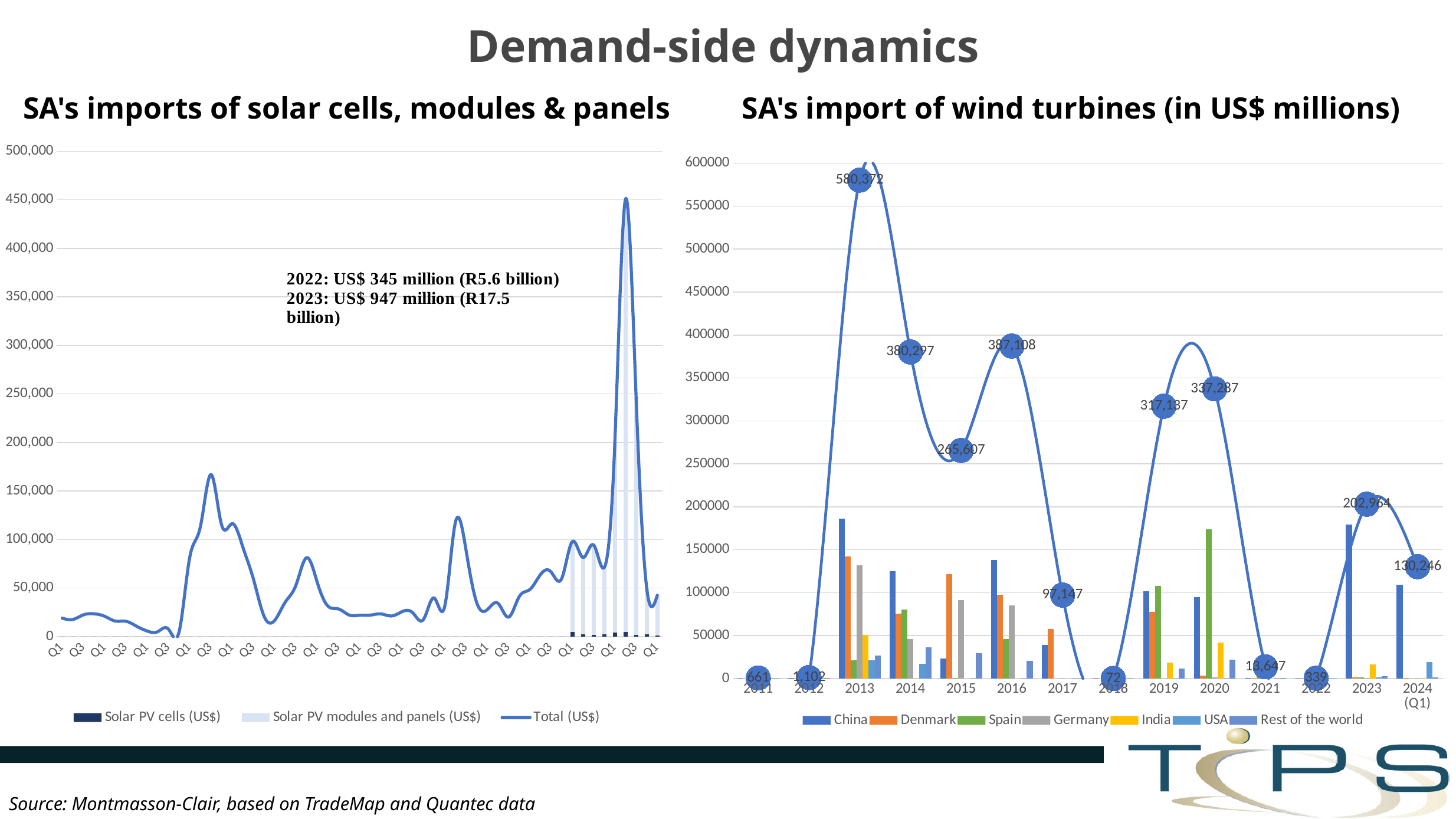
In the chart 'SA's import of wind turbines (in US$ millions)', which year has the highest labelled value? 2013 In the chart 'SA's import of wind turbines (in US$ millions)', which year has the larger labelled value, 2014 or 2016? 2016 In the chart 'SA's imports of solar cells, modules & panels', is the peak of the Total (US$) line greater or less than 400,000? greater In the chart 'SA's import of wind turbines (in US$ millions)', what is the difference between the labelled values for 2020 and 2019? 20,150 In the chart 'SA's import of wind turbines (in US$ millions)', what is the labelled value for 2013? 580,372 In the chart 'SA's import of wind turbines (in US$ millions)', what is the labelled value for 2024 (Q1)? 130,246 In the chart 'SA's import of wind turbines (in US$ millions)', which year has the lowest labelled value? 2018 In the chart 'SA's import of wind turbines (in US$ millions)', how many years are shown on the x axis? 14 In the chart 'SA's import of wind turbines (in US$ millions)', how many series does the legend list? 7 What kind of chart is 'SA's imports of solar cells, modules & panels'? Combined bar and line chart In the chart 'SA's import of wind turbines (in US$ millions)', is the China bar for 2013 greater or less than 150000? greater In the chart 'SA's imports of solar cells, modules & panels', how many series does the legend list? 3